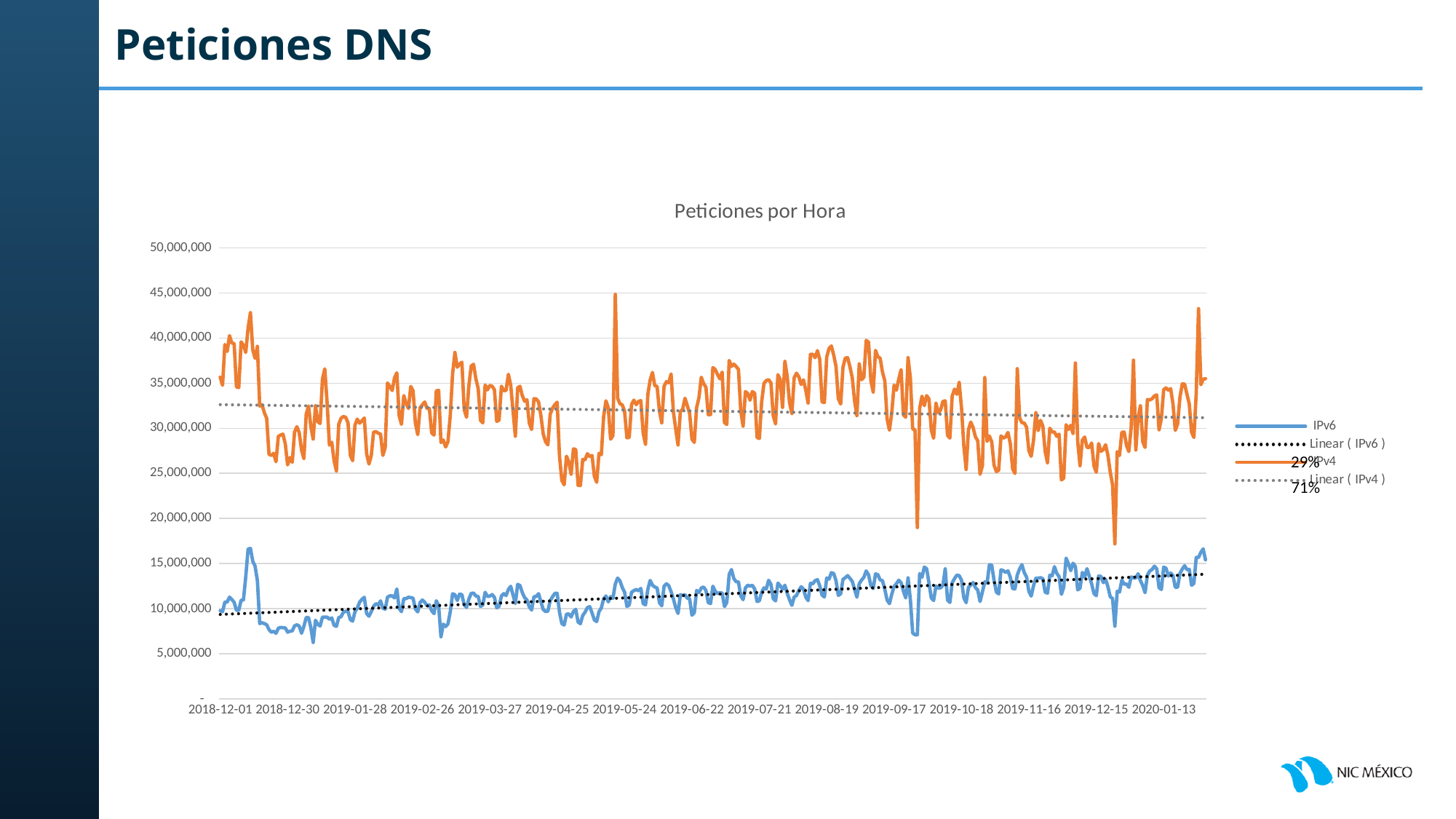
What is the highest value shown on the vertical axis? 50,000,000 Is the highest IPv4 peak on the chart greater or less than 40,000,000? greater Are all IPv6 values on the chart greater or less than 20,000,000? less Does the IPv6 series generally rise or fall from 2018-12-01 to 2020-01-13? rise Is the IPv4 value at 2019-08-19 greater or less than 30,000,000? greater What is the title of the chart? Peticiones por Hora Which series has higher values throughout the chart, IPv4 or IPv6? IPv4 How many entries does the chart legend list? 4 Which series is plotted with the orange line? IPv4 What kind of chart is shown on the slide? line chart